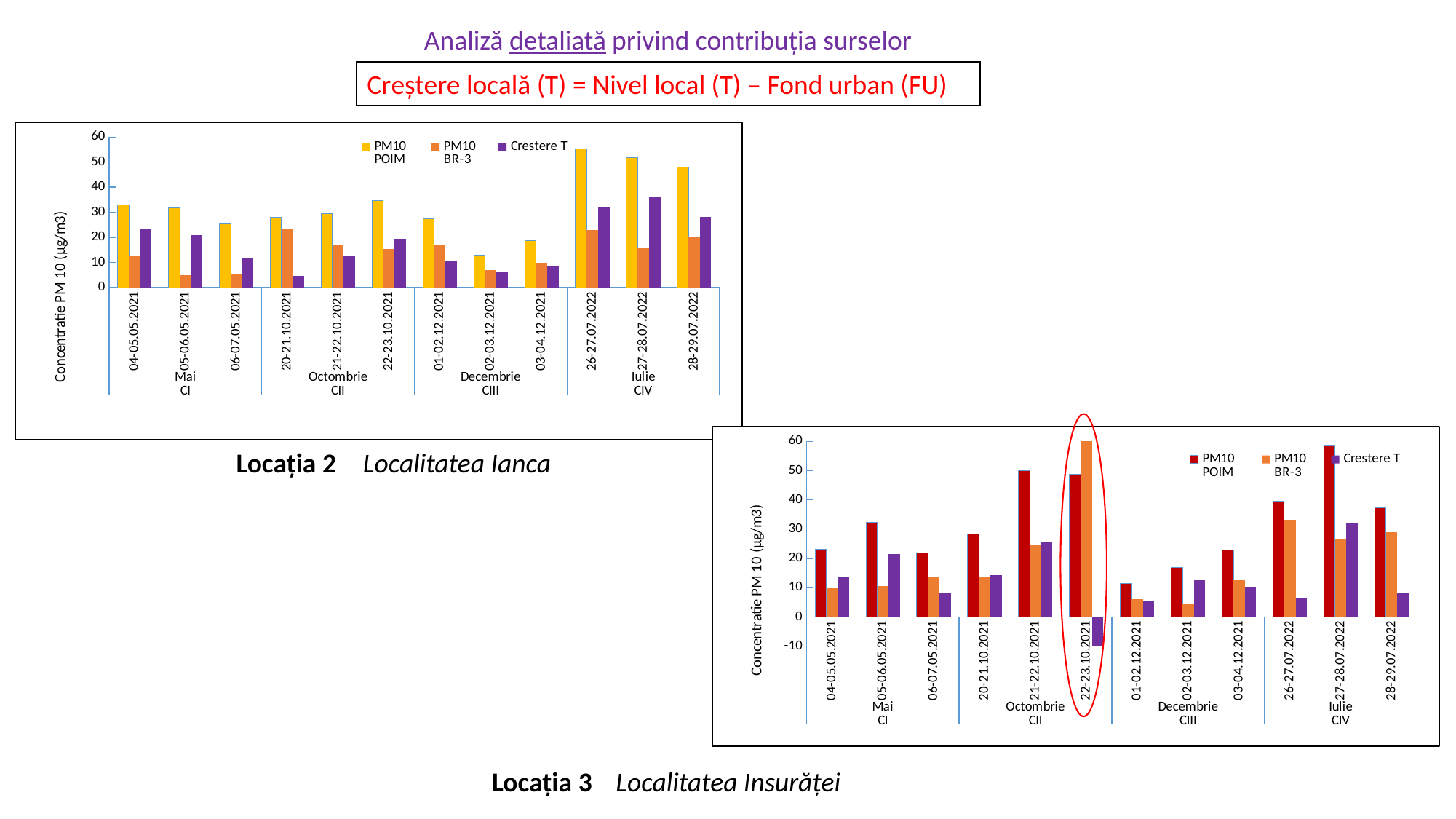
In the Locația 2 (Localitatea Ianca) chart, which date has the highest PM10 POIM value? 26-27.07.2022 In the Locația 3 (Localitatea Insurăței) chart, is the PM10 POIM value for 21-22.10.2021 greater or less than 40? greater What is the y-axis label of the Locația 2 (Localitatea Ianca) chart? Concentratie PM 10 (µg/m3) In the Locația 3 (Localitatea Insurăței) chart, which date has the highest PM10 BR-3 value? 22-23.10.2021 In the Locația 3 (Localitatea Insurăței) chart, which date has the highest PM10 POIM value? 27-28.07.2022 How many dates are shown on the x axis of the Locația 2 (Localitatea Ianca) chart? 12 In the Locația 2 (Localitatea Ianca) chart, which date has the lowest PM10 POIM value? 02-03.12.2021 How many series does the legend of the Locația 3 (Localitatea Insurăței) chart list? 3 What kind of chart is the Locația 2 (Localitatea Ianca) chart? bar chart In the Locația 3 (Localitatea Insurăței) chart, which date has a negative Crestere T value? 22-23.10.2021 In the Locația 2 (Localitatea Ianca) chart, is the PM10 POIM value for 26-27.07.2022 greater or less than 50? greater In the Locația 3 (Localitatea Insurăței) chart, for 22-23.10.2021, which is larger: PM10 POIM or PM10 BR-3? PM10 BR-3